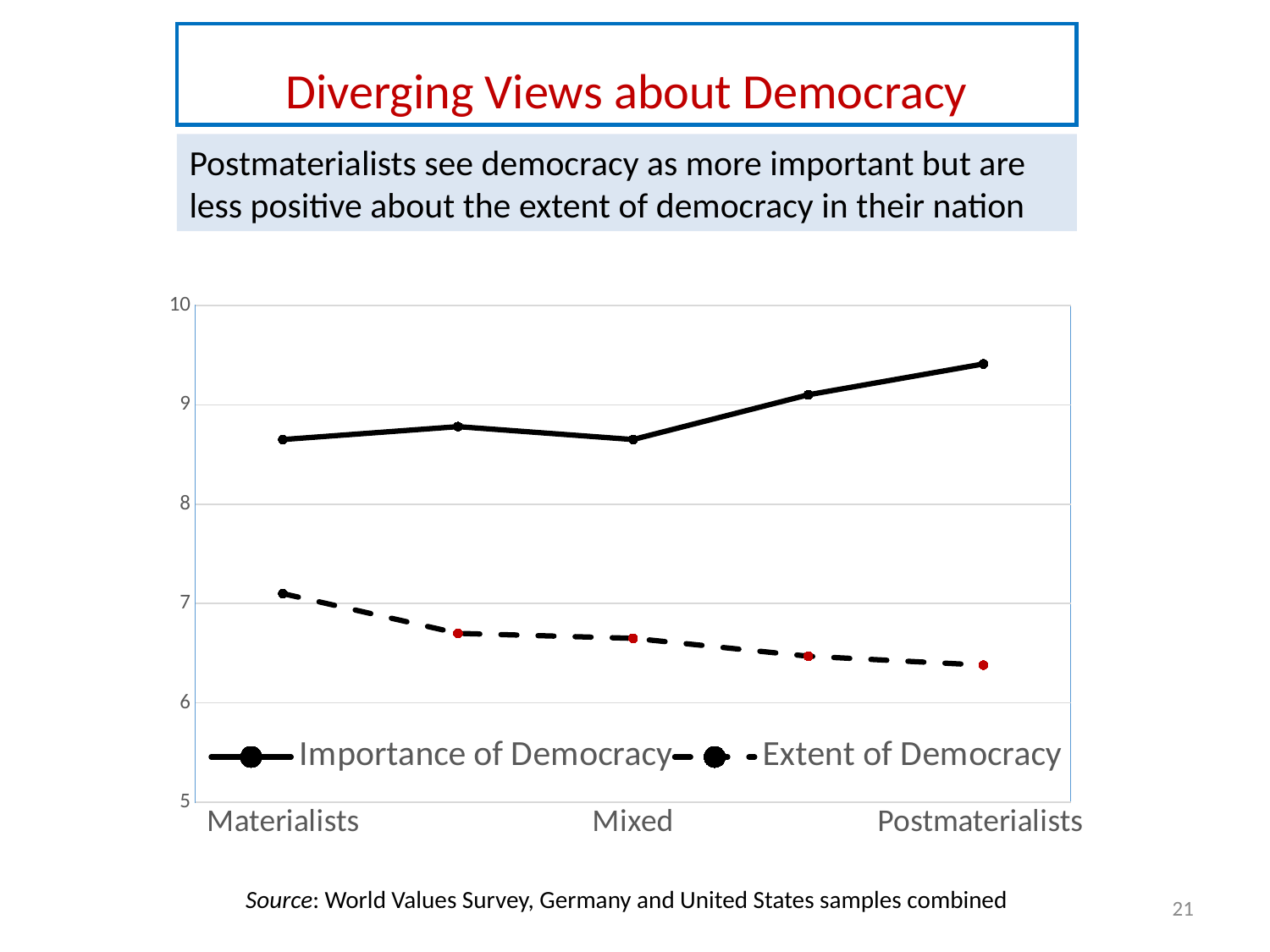
For Postmaterialists, which series has the larger value: Importance of Democracy or Extent of Democracy? Importance of Democracy What kind of chart is shown on the slide? Line chart Is the Extent of Democracy value for Materialists greater or less than 7? greater For which labeled group is the Extent of Democracy value highest? Materialists Is the Importance of Democracy value for Materialists greater or less than 9? less How many data points does the Importance of Democracy line have? 5 How many series does the chart legend list? 2 Does the Importance of Democracy line rise or fall overall from Materialists to Postmaterialists? Rise Which two series are listed in the chart legend? Importance of Democracy and Extent of Democracy Is the Extent of Democracy value for Postmaterialists greater or less than 7? less Does the Extent of Democracy line rise or fall from Materialists to Postmaterialists? Fall